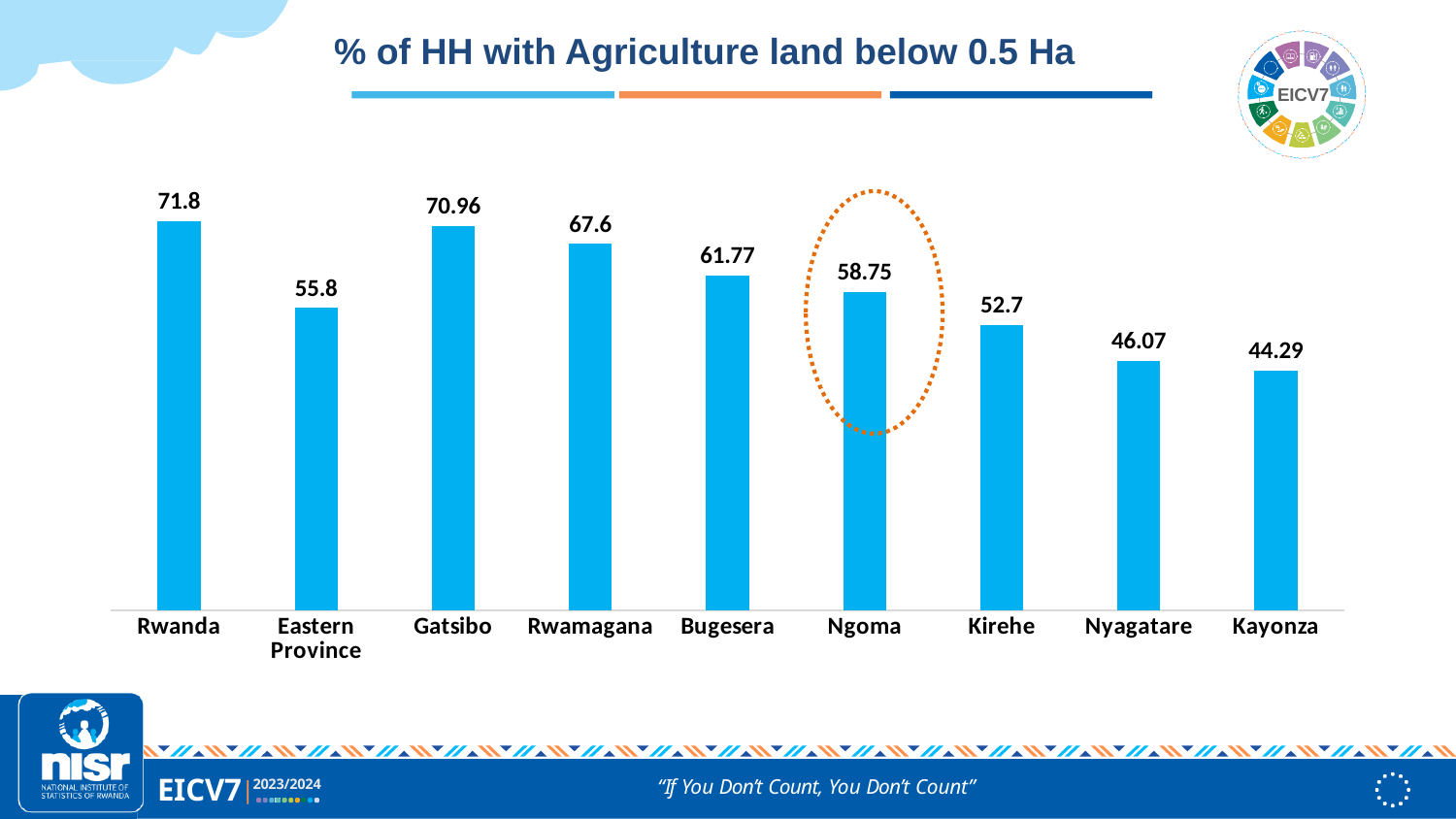
Which category's bar is highlighted with a dotted orange circle? Ngoma What is the value for Kayonza? 44.29 What is the value for Ngoma? 58.75 How many categories are shown on the x axis? 9 What kind of chart is shown on the slide? Bar chart What is the value for Gatsibo? 70.96 Which category has the lowest value? Kayonza Which category has the highest value? Rwanda Which is larger, the value for Rwamagana or the value for Nyagatare? Rwamagana What is the difference between the values for Bugesera and Kirehe? 9.07 What is the difference between the values for Rwanda and Eastern Province? 16 What is the value for Eastern Province? 55.8